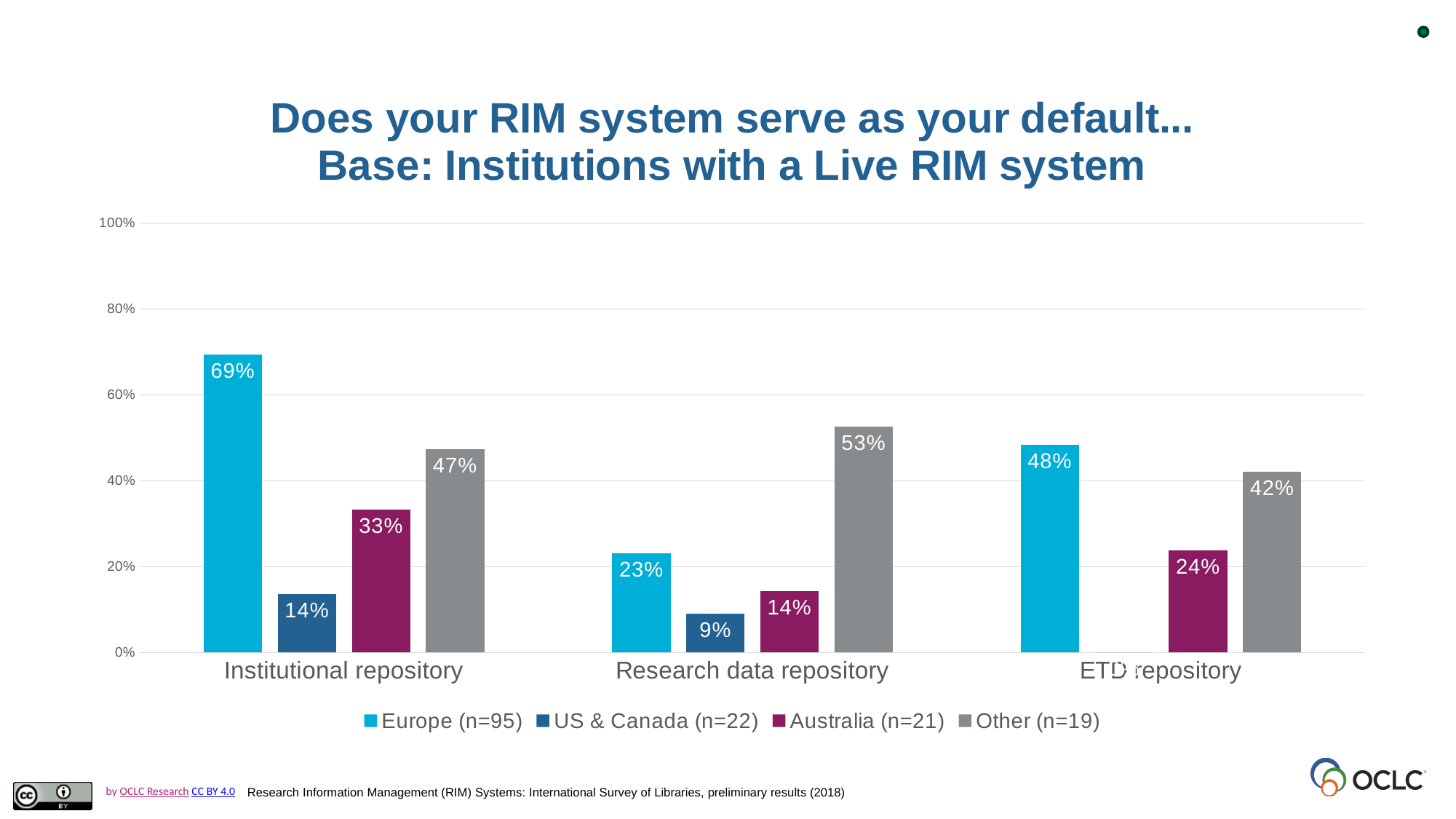
Which series has the highest value for Institutional repository? Europe (n=95) What is the value for Other (n=19) for Research data repository? 53% What kind of chart is shown on the slide? Bar chart What is the difference between the Europe (n=95) and Other (n=19) values for ETD repository? 6% What is the value for Australia (n=21) for ETD repository? 24% What colour are the bars for the Australia (n=21) series? Purple How many categories are shown on the x axis? 3 Which is larger for Research data repository: the Europe (n=95) value or the Australia (n=21) value? Europe (n=95) What is the value for Europe (n=95) for Institutional repository? 69% How many series does the legend list? 4 What is the value for US & Canada (n=22) for Research data repository? 9% Which series has the lowest value for Research data repository? US & Canada (n=22)